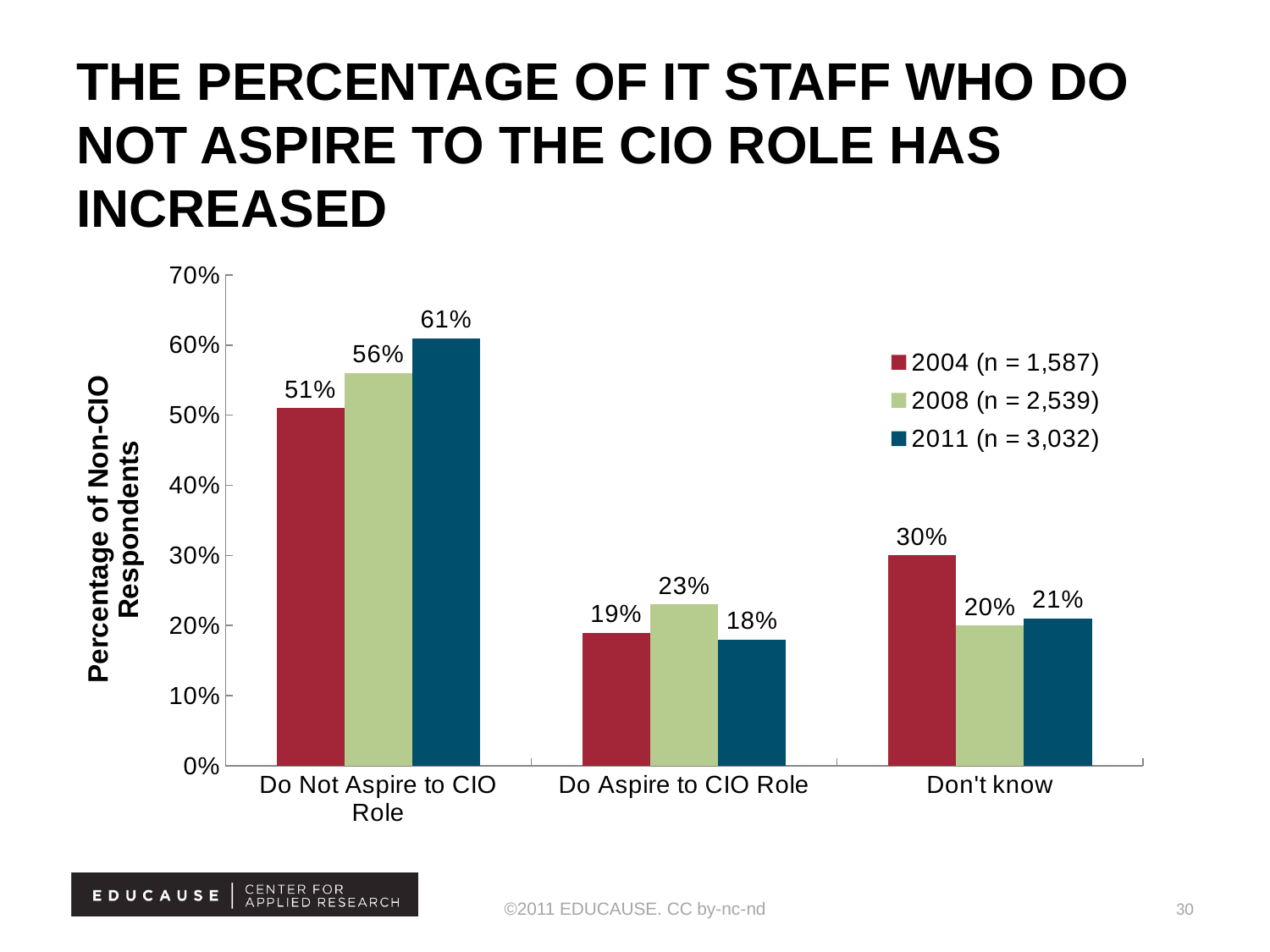
What kind of chart is shown on the slide? Bar chart Which survey year has the lowest value for 'Do Aspire to CIO Role'? 2011 Which survey year has the highest value for 'Do Not Aspire to CIO Role'? 2011 What percentage of non-CIO respondents in 2004 answered 'Don't know'? 30% What is the difference between the 2011 and 2004 values for 'Do Not Aspire to CIO Role'? 10 percentage points How many series does the legend list? 3 How many response categories are shown on the x axis? 3 What percentage of non-CIO respondents in 2011 did not aspire to the CIO role? 61% What is the label of the y axis? Percentage of Non-CIO Respondents What is the sample size (n) for the 2011 series shown in the legend? 3,032 What percentage of non-CIO respondents in 2008 did aspire to the CIO role? 23% Which is larger: the 2004 value for 'Don't know' or the 2008 value for 'Don't know'? 2004